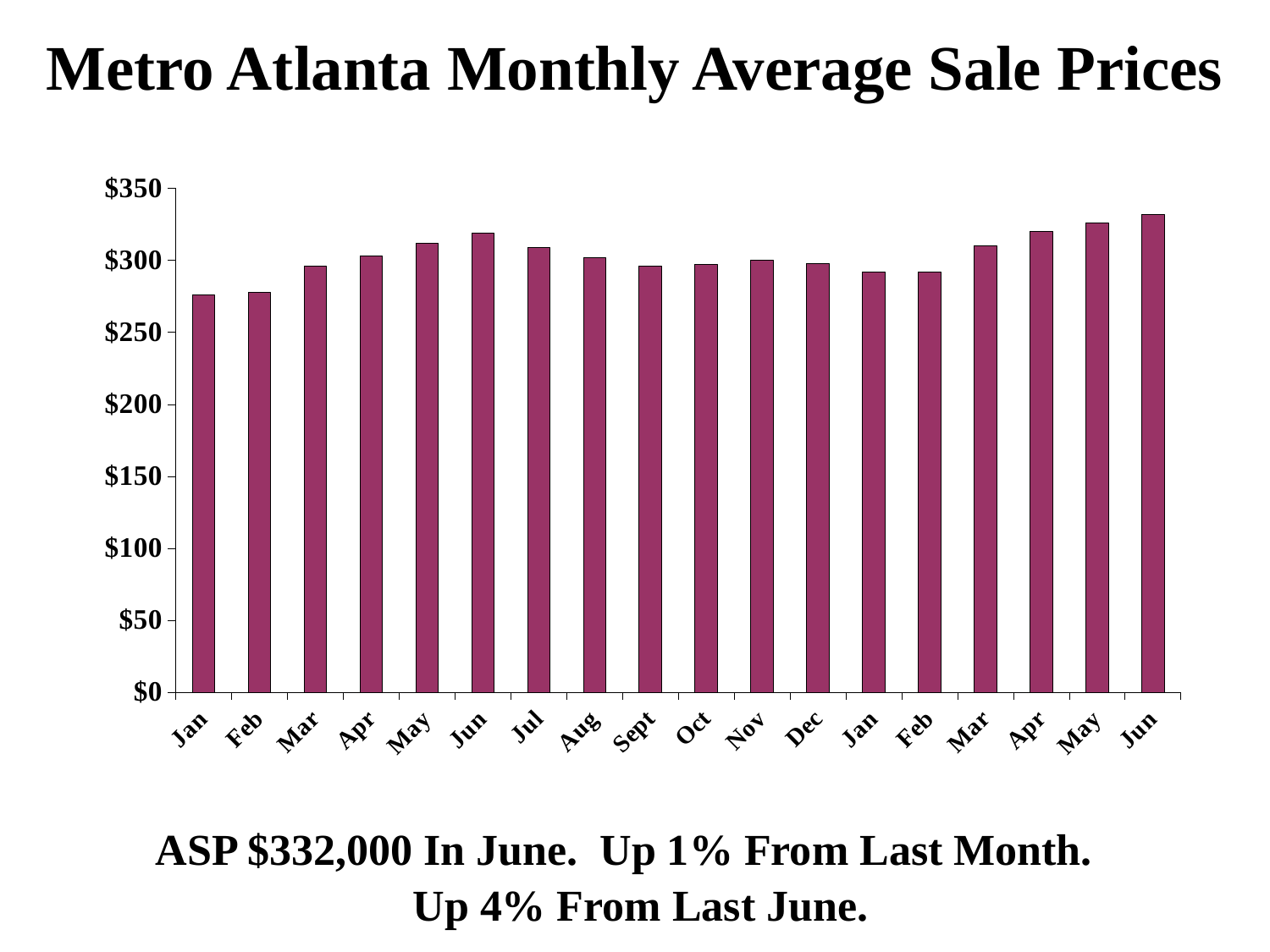
What kind of chart is shown on the slide? bar chart Which is larger, the first Jan bar or the last Jun bar? the last Jun bar Is the value for the first Jan bar greater or less than $300? less Is the value for the last Jun bar greater or less than $300? greater How many bars (months) are plotted in the chart? 18 Is the value for the second Jan bar greater or less than $300? less What is the title of the chart? Metro Atlanta Monthly Average Sale Prices Which is larger, the first May bar or the second May bar? the second May bar Do the values rise or fall from the second Jan bar to the last Jun bar? rise Which month has the highest bar in the chart? Jun (the last bar)